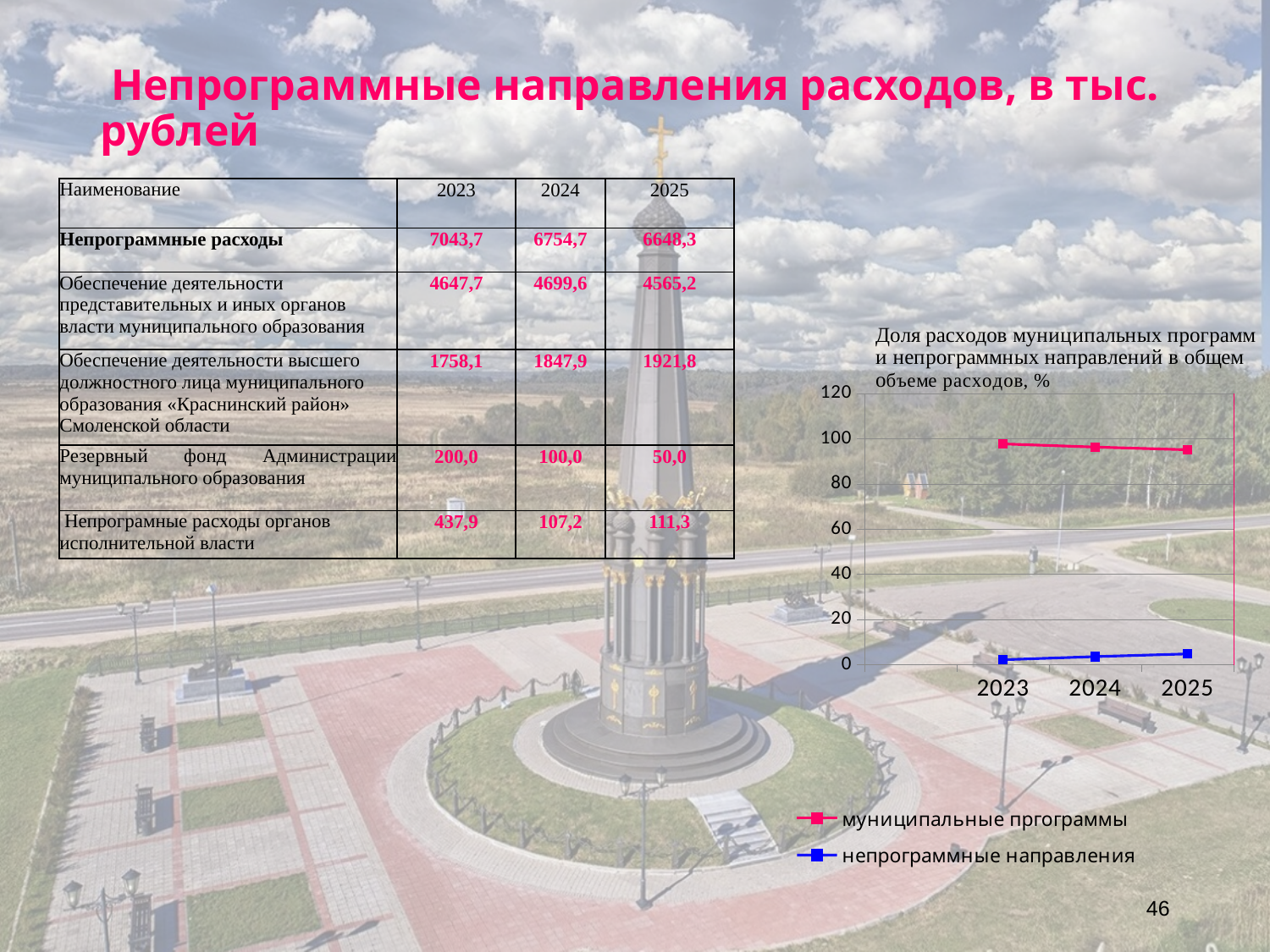
In the line chart, do the values for непрограммные направления rise or fall from 2023 to 2025? rise In the line chart, do the values for муниципальные программы rise or fall from 2023 to 2025? fall What is the title of the line chart? Доля расходов муниципальных программ и непрограммных направлений в общем объеме расходов, % What colour is the line for непрограммные направления in the line chart? blue In the line chart, in which year is the value for муниципальные программы highest? 2023 How many series does the legend of the line chart list? 2 What kind of chart is shown on the right side of the slide? line chart How many years are shown on the x axis of the line chart? 3 In the line chart, is the value for муниципальные программы in 2025 greater or less than 100? less In the line chart, is the value for непрограммные направления in 2025 greater or less than 20? less In the line chart, which series has the larger value in 2024: муниципальные программы or непрограммные направления? муниципальные программы In the line chart, is the value for муниципальные программы in 2023 greater or less than 80? greater